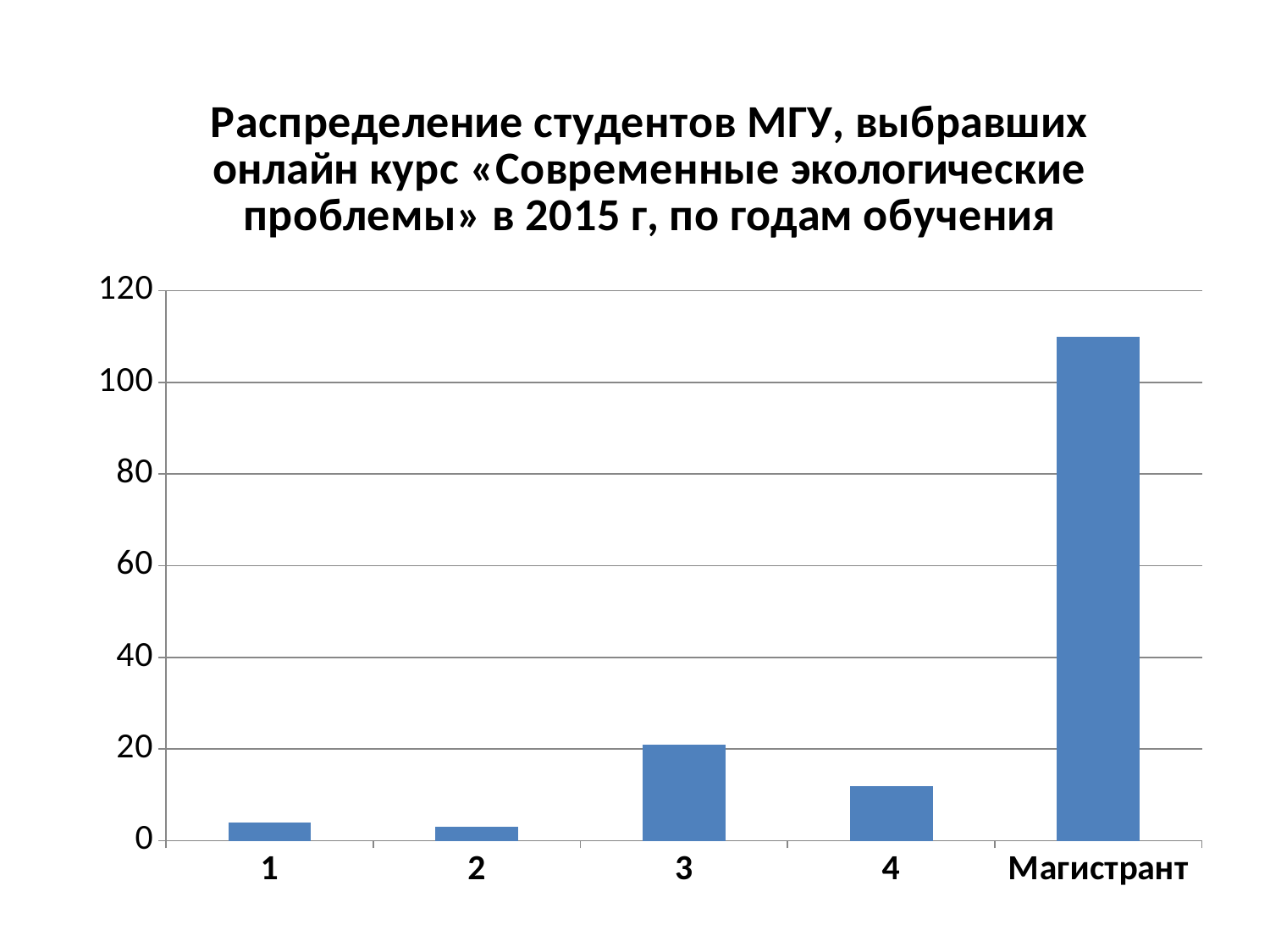
How many categories are shown on the x axis of the chart? 5 Is the value for category 3 greater or less than 40? less Which is larger, the value for category 3 or the value for category 4? category 3 Which category has the highest value in the chart? Магистрант What kind of chart is shown on the slide? bar chart Is the value for category 1 greater or less than 20? less Is the value for category 4 greater or less than 20? less Which is larger, the value for category 4 or the value for category 2? category 4 What colour are the bars in the chart? blue What is the title of the chart? Распределение студентов МГУ, выбравших онлайн курс «Современные экологические проблемы» в 2015 г, по годам обучения